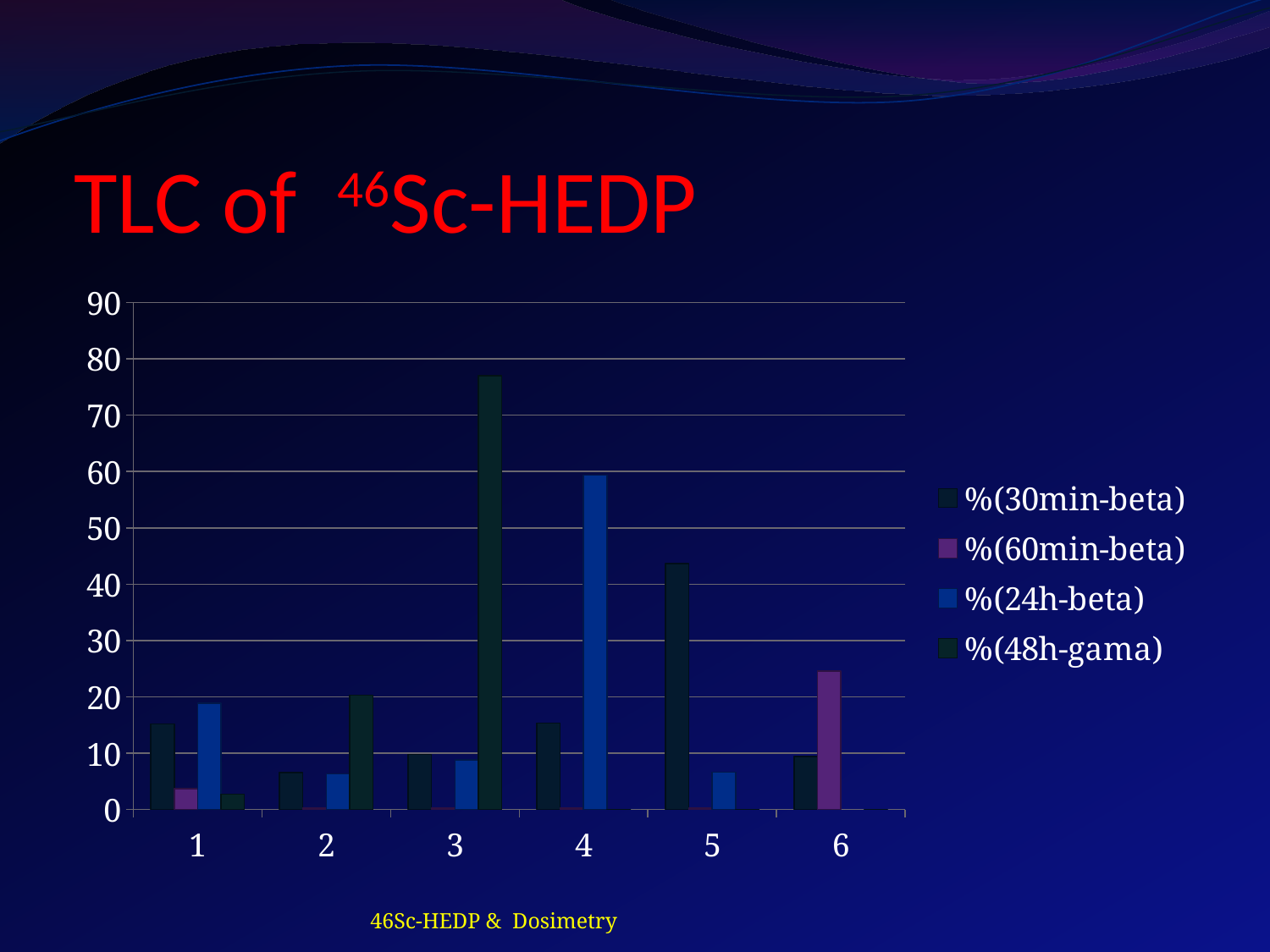
Which legend entry is shown in blue? %(24h-beta) Is the value for %(30min-beta) at category 5 greater or less than 30? greater What is the title of the slide containing the chart? TLC of 46Sc-HEDP What kind of chart is shown on the slide? bar chart Which category has the highest value for %(48h-gama)? 3 How many categories are shown on the x axis? 6 How many series does the legend list? 4 At category 6, which series has the larger value: %(30min-beta) or %(60min-beta)? %(60min-beta) Is the value for %(24h-beta) at category 4 greater or less than 50? greater Is the value for %(48h-gama) at category 3 greater or less than 70? greater Which category has the highest value for %(24h-beta)? 4